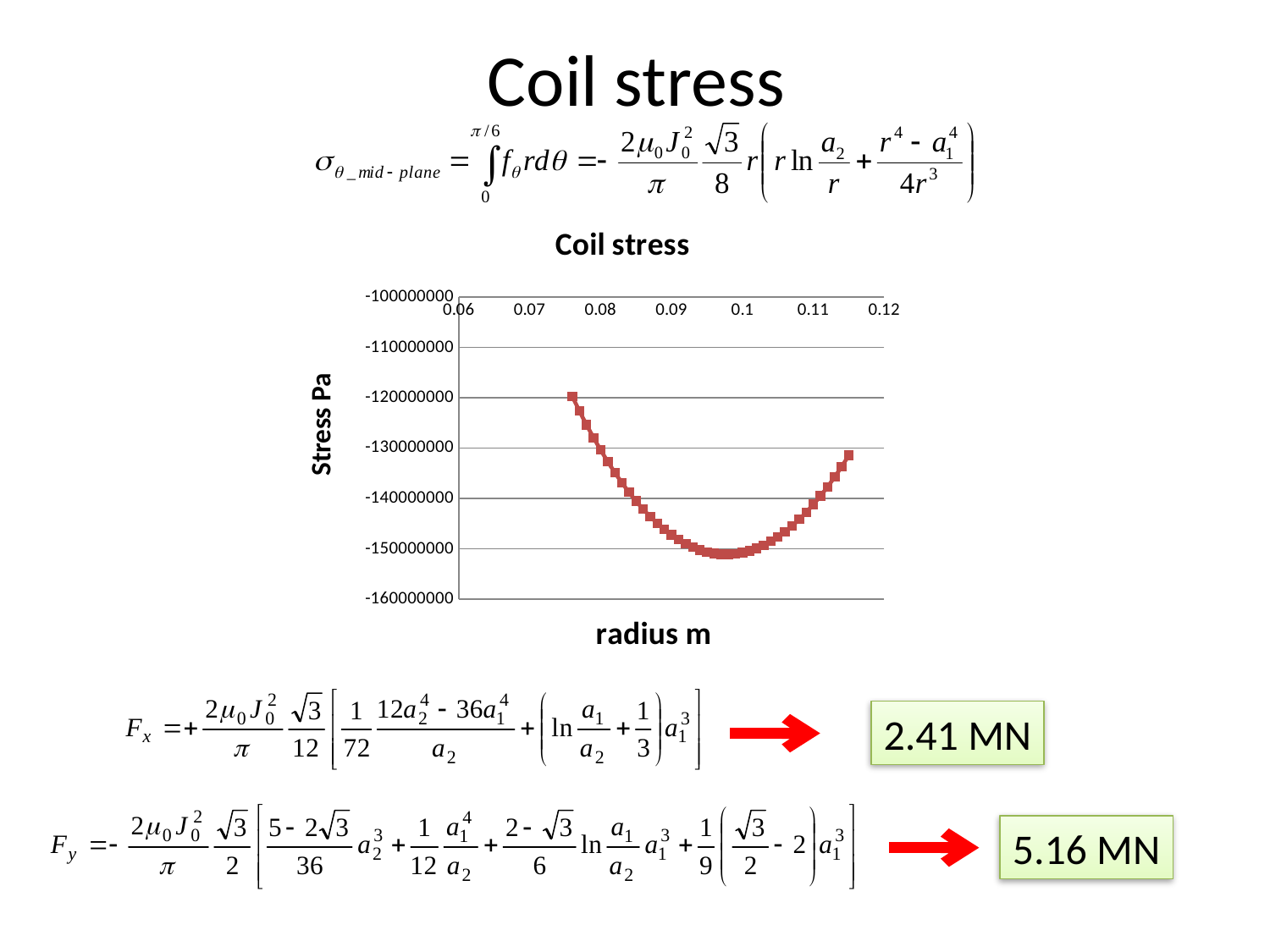
What is the lowest value shown on the vertical axis of the chart? -160000000 Is the stress value at radius 0.09 greater or less than -140000000? less What is the label of the vertical axis of the chart? Stress Pa Is the stress value at the smallest plotted radius greater or less than -130000000? greater Is the stress value at radius 0.1 greater or less than the value at radius 0.08? less How does the stress change as the radius increases from 0.08 to 0.1? it falls Is the lowest stress value on the chart greater or less than -140000000? less How does the stress change as the radius increases from 0.1 to 0.115? it rises What kind of chart is shown on the slide? scatter chart What is the title of the chart? Coil stress